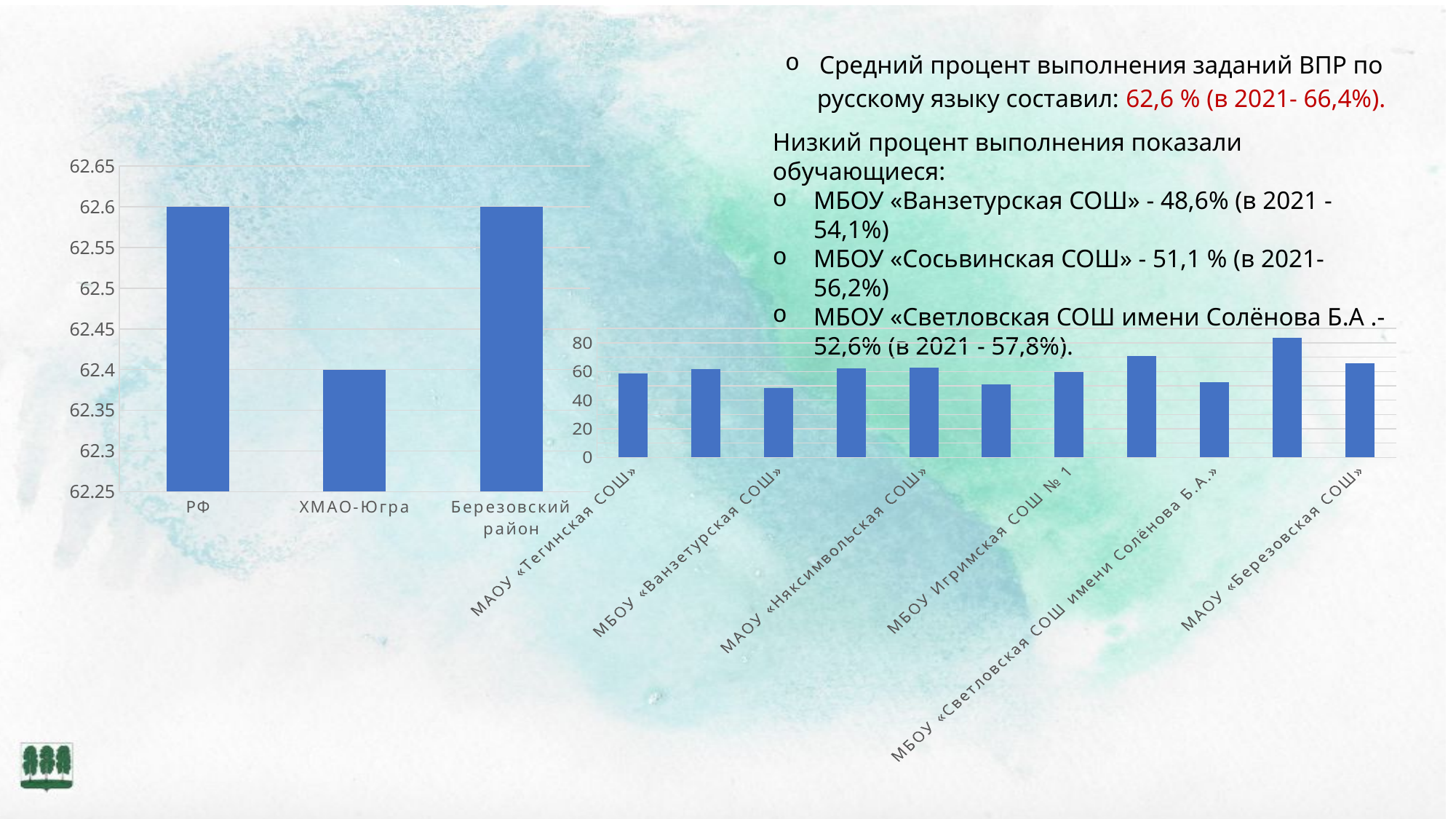
In the left chart, which category has the lowest value? ХМАО-Югра In the right chart, how many bars are plotted? 11 What kind of chart is the left chart? bar chart In the left chart, what is the value for ХМАО-Югра? 62.4 In the left chart, how many categories are shown? 3 In the left chart, what is the value for РФ? 62.6 In the left chart, what is the difference between the values for РФ and ХМАО-Югра? 0.2 In the right chart, is the value for МАОУ «Березовская СОШ» greater or less than 60? greater In the left chart, which is larger: the value for РФ or for ХМАО-Югра? РФ In the right chart, is the value for МБОУ «Ванзетурская СОШ» greater or less than 60? less In the right chart, which is larger: the value for МБОУ «Ванзетурская СОШ» or for МАОУ «Березовская СОШ»? МАОУ «Березовская СОШ» In the left chart, what is the value for Березовский район? 62.6